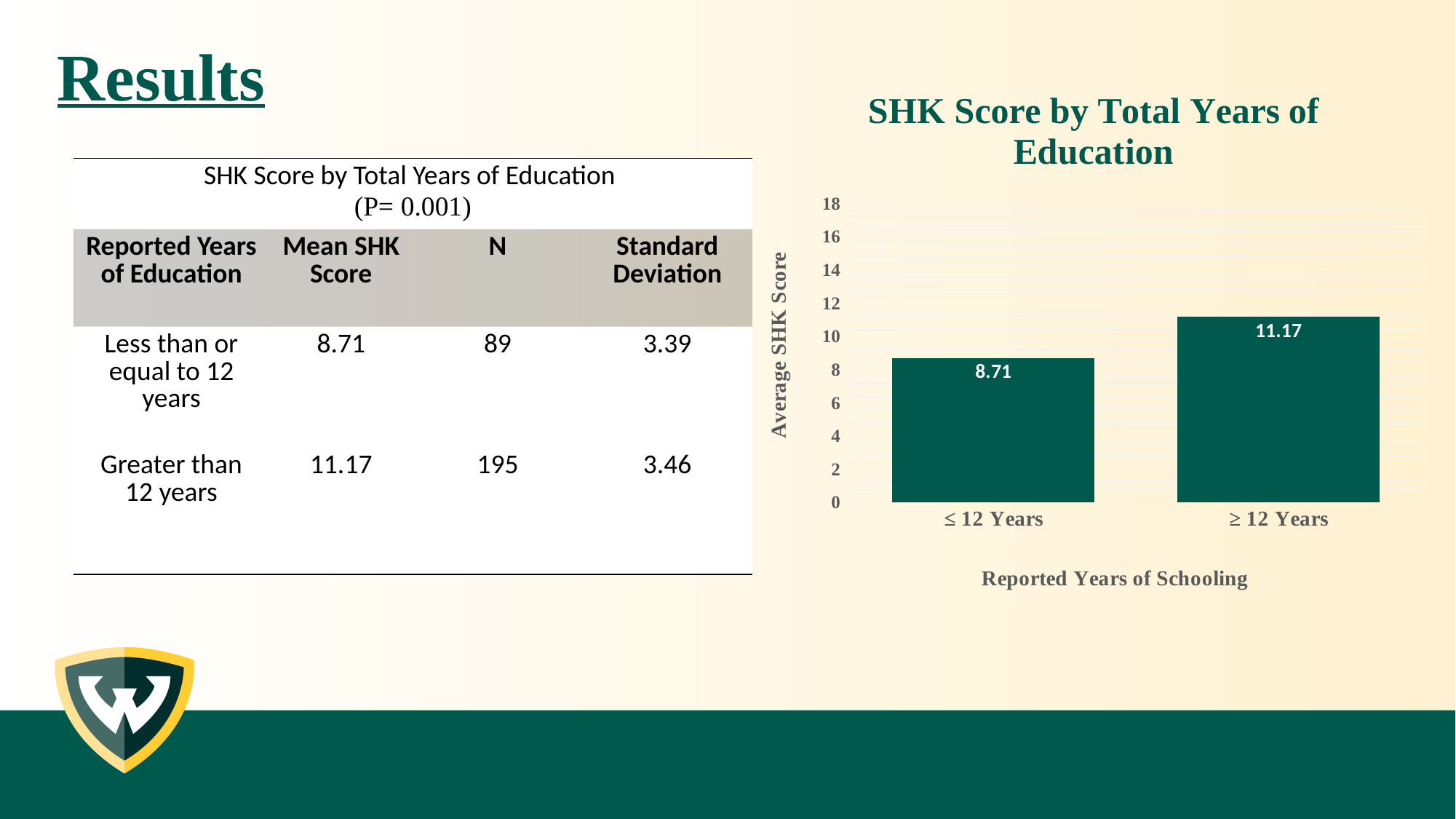
What is the difference between the average SHK scores of the ≥ 12 Years and ≤ 12 Years categories? 2.46 What kind of chart is shown on the slide? bar chart Which is larger, the average SHK score for ≤ 12 Years or for ≥ 12 Years? ≥ 12 Years What is the title of the chart? SHK Score by Total Years of Education Which category has the lowest average SHK score? ≤ 12 Years How many categories are shown on the x axis of the chart? 2 What is the label of the chart's y axis? Average SHK Score Which category has the highest average SHK score? ≥ 12 Years Is the value for ≤ 12 Years greater or less than 10? less Is the value for ≥ 12 Years greater or less than 10? greater What is the average SHK score for the ≥ 12 Years category? 11.17 What is the average SHK score for the ≤ 12 Years category? 8.71